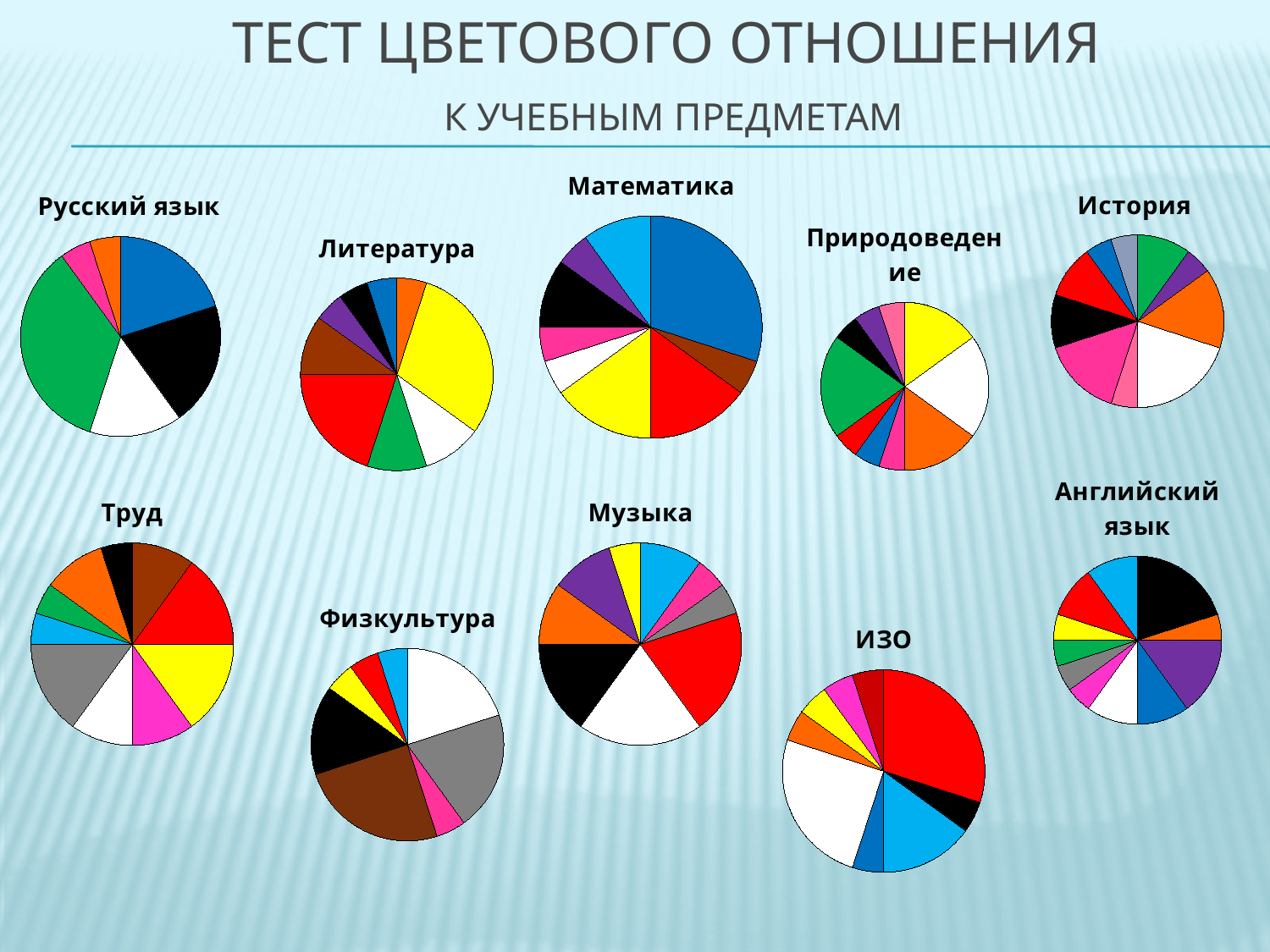
What kind of charts are shown on the slide? Pie charts In the 'Литература' pie chart, how many slices are there? 9 How many pie charts are on the slide? 10 What is the title of the pie chart in the top-left corner of the slide? Русский язык In the 'ИЗО' pie chart, which colour is the largest slice? Red In the 'Математика' pie chart, which slice is larger, the blue one or the black one? Blue In the 'Математика' pie chart, which colour is the largest slice? Blue In the 'Русский язык' pie chart, which colour is the largest slice? Green In the 'Русский язык' pie chart, which slice is larger, the green one or the pink one? Green In the 'ИЗО' pie chart, how many slices are there? 9